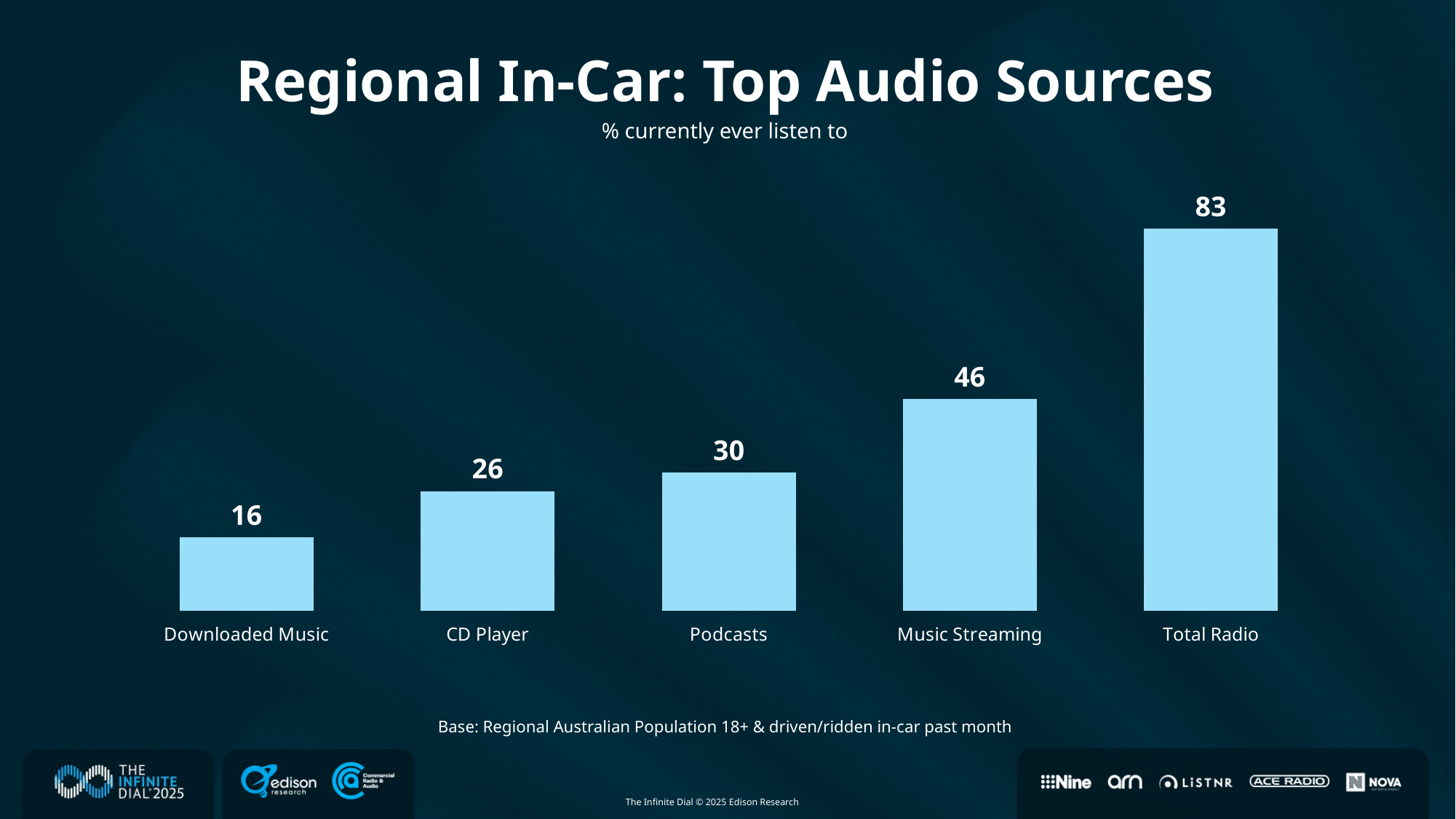
What is the difference between the values for Total Radio and Music Streaming? 37 What kind of chart is shown on the slide? Bar chart Which audio source has the lowest value? Downloaded Music What is the value for Total Radio? 83 Which audio source has the highest value? Total Radio What is the value for Podcasts? 30 What is the value for Music Streaming? 46 Which is larger, the value for Podcasts or the value for CD Player? Podcasts What is the value for Downloaded Music? 16 What is the difference between the values for CD Player and Downloaded Music? 10 How many audio sources are shown in the chart? 5 What is the title of the chart? Regional In-Car: Top Audio Sources